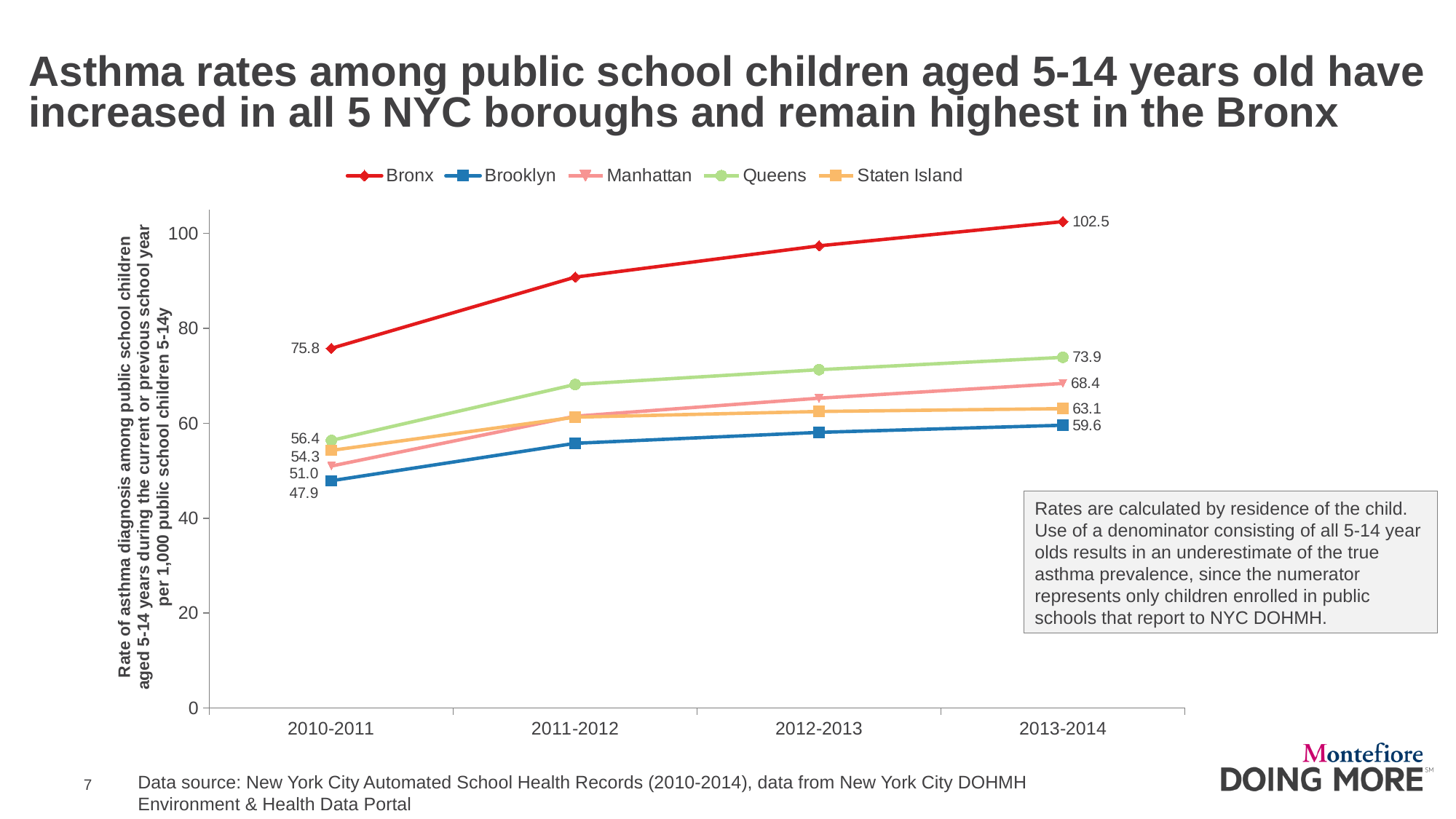
What is the asthma rate for the Bronx in 2013-2014? 102.5 Is the Bronx asthma rate in 2011-2012 greater or less than 80? greater Which borough has the lowest asthma rate in 2010-2011? Brooklyn What is the asthma rate for Queens in 2013-2014? 73.9 Which is larger in 2013-2014, the rate for Manhattan or the rate for Staten Island? Manhattan How many school years are plotted along the x axis? 4 How many series does the legend list? 5 What is the asthma rate for Brooklyn in 2010-2011? 47.9 By how much did the Bronx asthma rate increase from 2010-2011 to 2013-2014? 26.7 Which borough has the highest asthma rate in 2013-2014? Bronx What type of chart is shown on the slide? line chart Does the asthma rate for Queens rise or fall from 2010-2011 to 2013-2014? rise